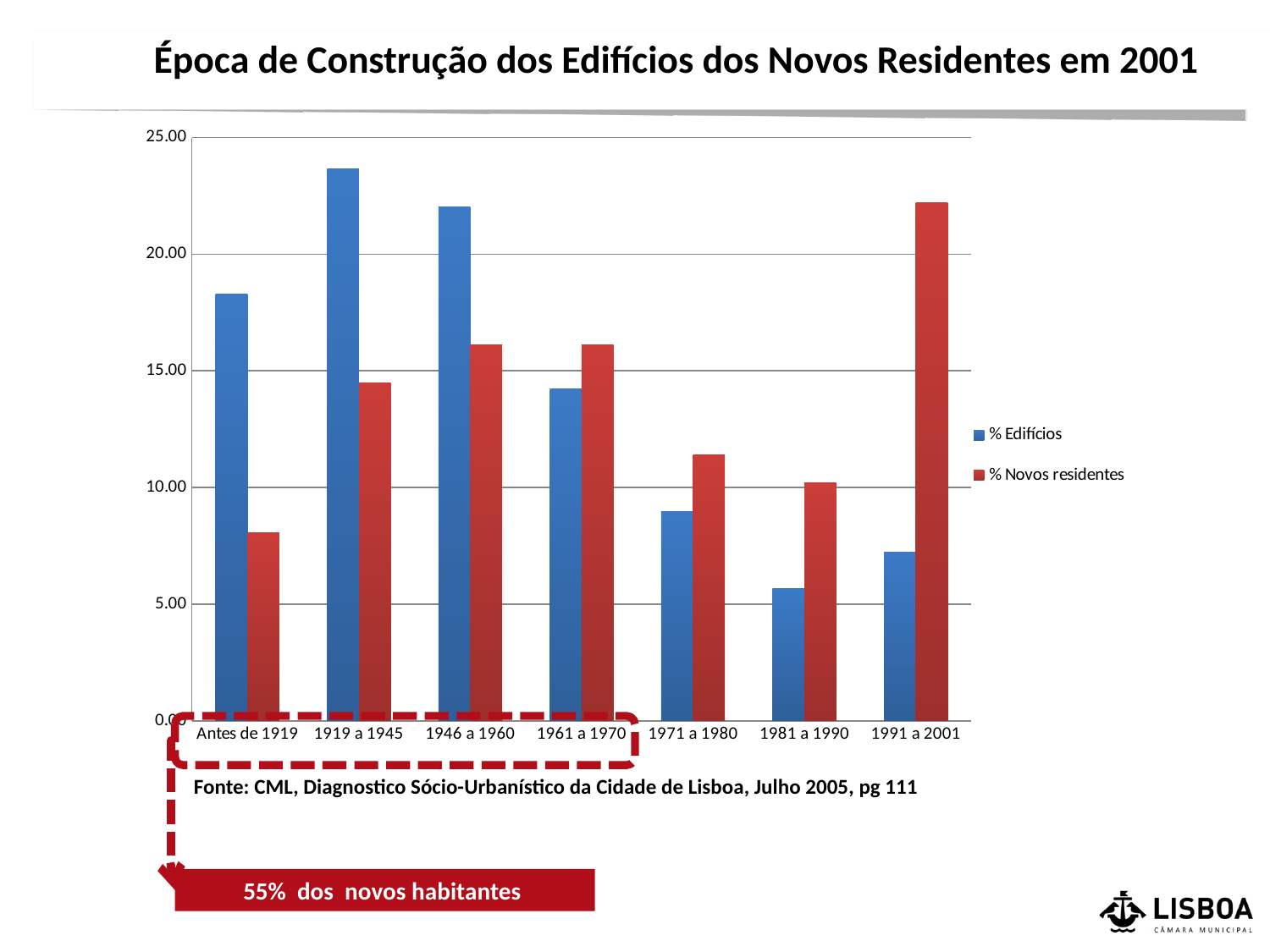
Which category has the lowest value for % Novos residentes? Antes de 1919 Which category has the highest value for % Novos residentes? 1991 a 2001 For 1991 a 2001, which is larger: % Edifícios or % Novos residentes? % Novos residentes What kind of chart is shown on the slide? bar chart Which category has the lowest value for % Edifícios? 1981 a 1990 Which category has the highest value for % Edifícios? 1919 a 1945 What colour are the bars for % Novos residentes? red Is the value for % Novos residentes in 1991 a 2001 greater or less than 20.00? greater For Antes de 1919, which is larger: % Edifícios or % Novos residentes? % Edifícios How many construction-period categories are shown on the x axis? 7 How many series does the legend list? 2 Is the value for % Edifícios in 1971 a 1980 greater or less than 10.00? less